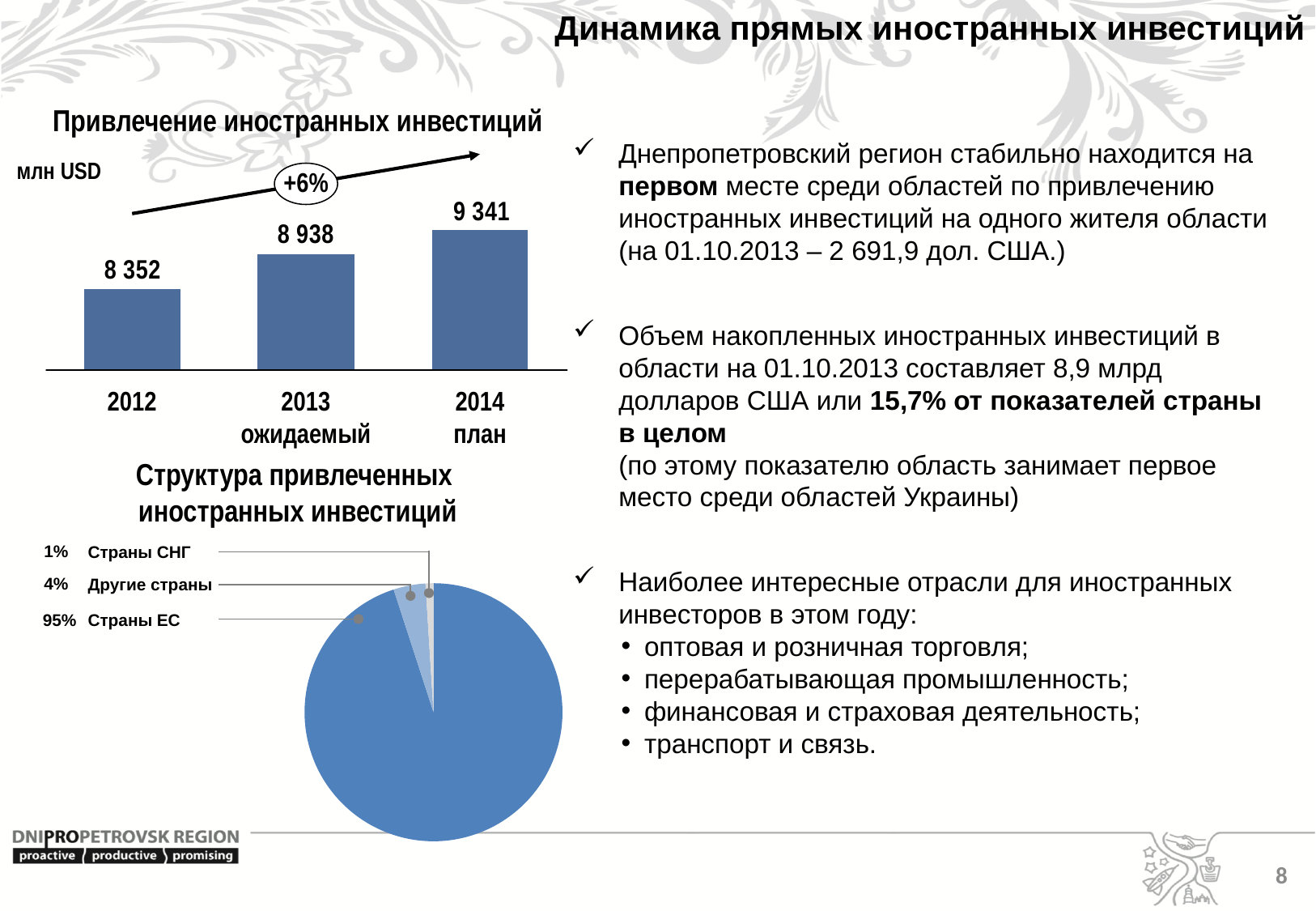
What type of chart is 'Привлечение иностранных инвестиций'? bar chart In the chart 'Привлечение иностранных инвестиций', what is the difference between the 2014 план value and the 2012 value? 989 In the chart 'Привлечение иностранных инвестиций', how many bars are shown? 3 In the chart 'Структура привлеченных иностранных инвестиций', which category has the smallest share? Страны СНГ In the chart 'Структура привлеченных иностранных инвестиций', what is the difference between the share of Другие страны and Страны СНГ? 3% In the chart 'Привлечение иностранных инвестиций', do the values rise or fall from 2012 to 2014? rise In the chart 'Структура привлеченных иностранных инвестиций', what share do Страны ЕС have? 95% In the chart 'Привлечение иностранных инвестиций', what is the value for 2013 ожидаемый? 8 938 In the chart 'Привлечение иностранных инвестиций', which year has the highest value? 2014 план In the chart 'Привлечение иностранных инвестиций', what is the value for 2012? 8 352 In the chart 'Привлечение иностранных инвестиций', what is the value for 2014 план? 9 341 In the chart 'Привлечение иностранных инвестиций', which year has the lowest value? 2012